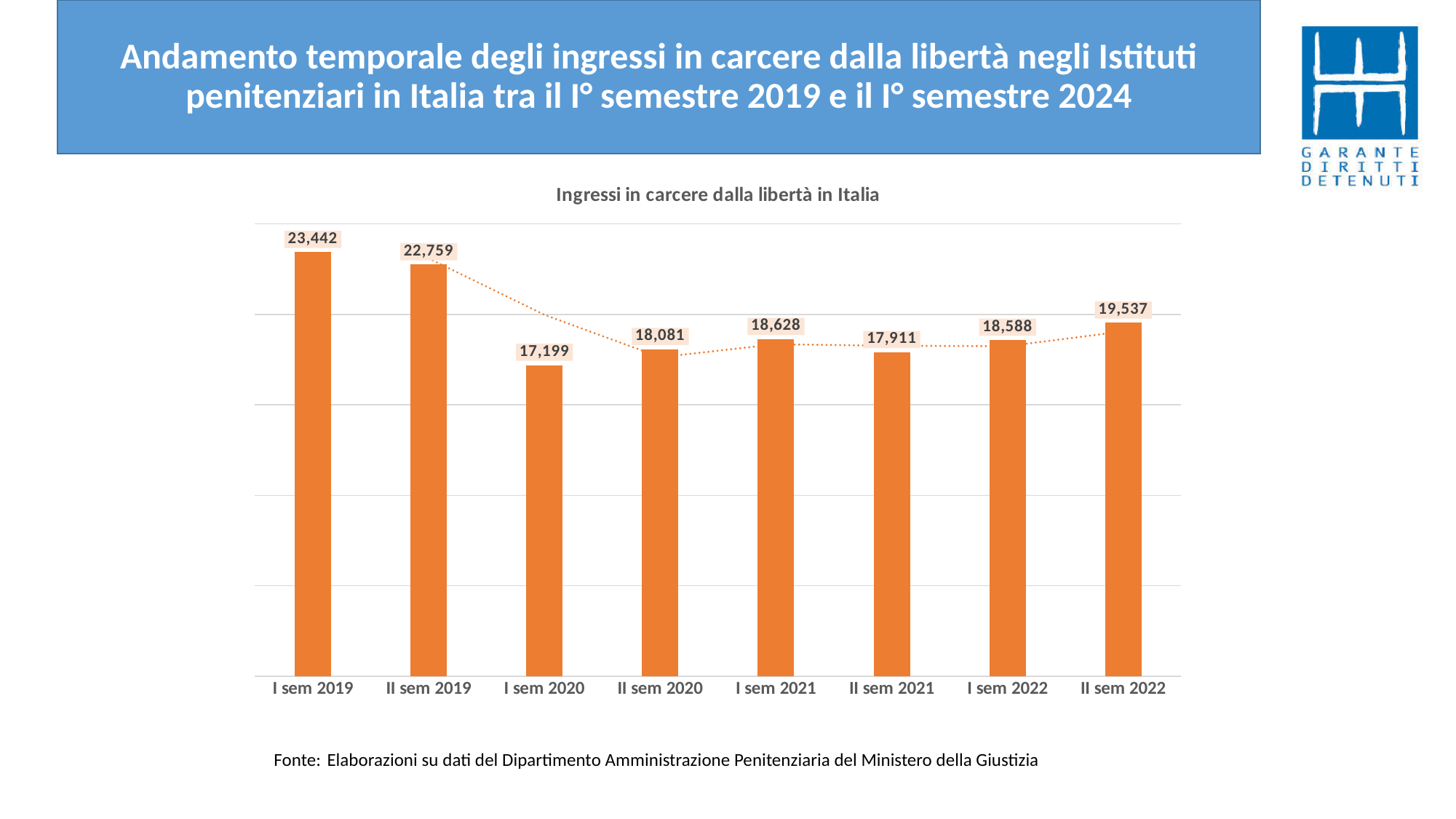
What is the value for II sem 2022? 19,537 What is the difference between the values for I sem 2019 and II sem 2019? 683 What is the value for II sem 2020? 18,081 What is the title of the chart? Ingressi in carcere dalla libertà in Italia What kind of chart is this? Bar chart How many semesters are shown on the x axis? 8 Which semester has the lowest value? I sem 2020 Do the values rise or fall from I sem 2019 to I sem 2020? Fall Which is larger, the value for I sem 2022 or II sem 2022? II sem 2022 What is the difference between the values for I sem 2019 and I sem 2020? 6,243 Which semester has the highest value? I sem 2019 What is the value for I sem 2019? 23,442